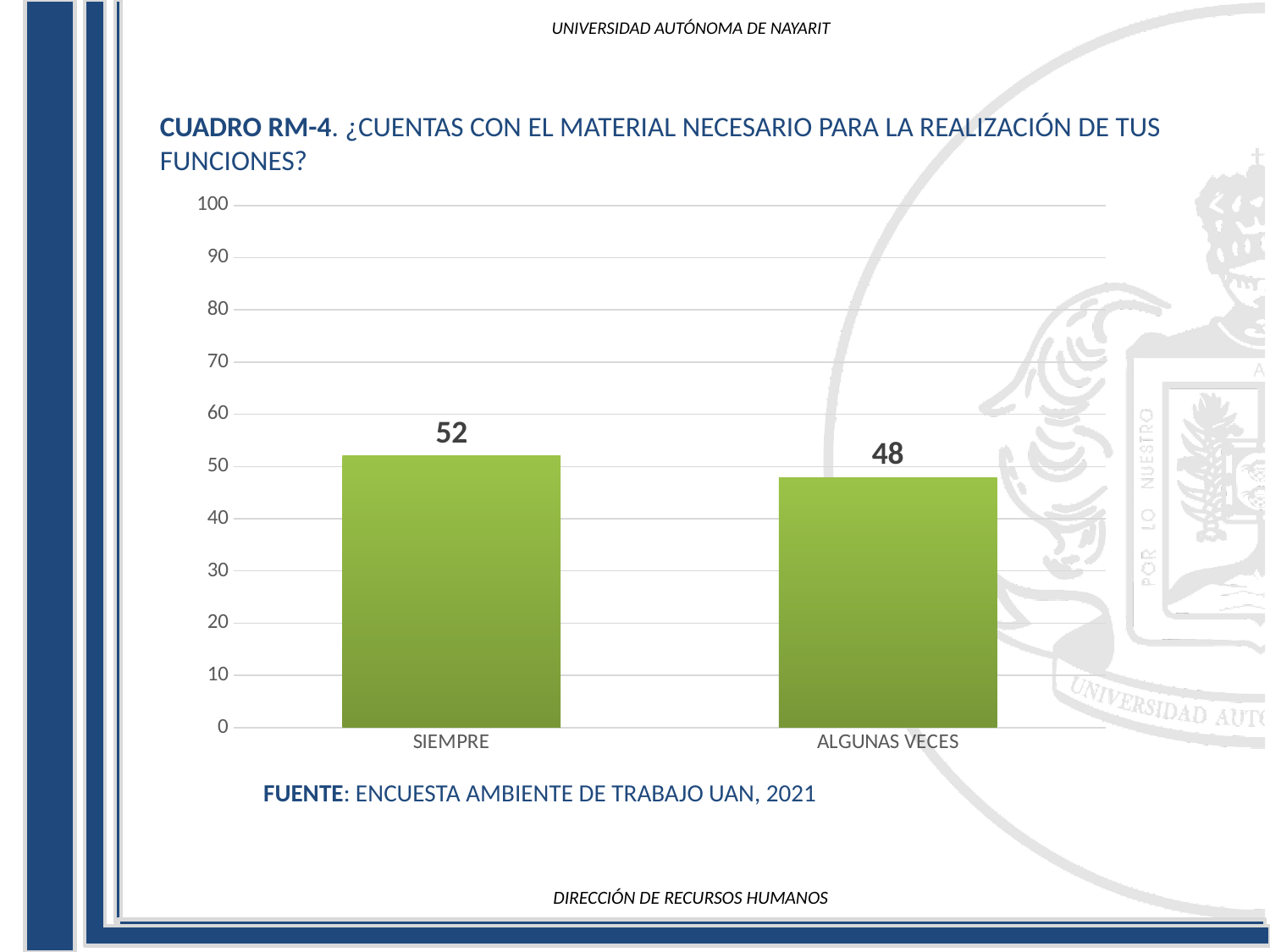
Which is larger, the value for SIEMPRE or the value for ALGUNAS VECES? SIEMPRE What source is cited below the chart? ENCUESTA AMBIENTE DE TRABAJO UAN, 2021 What is the maximum value shown on the y axis? 100 Which category has the highest value? SIEMPRE Is the value for ALGUNAS VECES greater or less than 50? less Which category has the lowest value? ALGUNAS VECES How many categories are shown on the x axis? 2 What is the value for SIEMPRE? 52 What is the difference between the values for SIEMPRE and ALGUNAS VECES? 4 Is the value for SIEMPRE greater or less than 50? greater What kind of chart is shown on the slide? bar chart What is the value for ALGUNAS VECES? 48